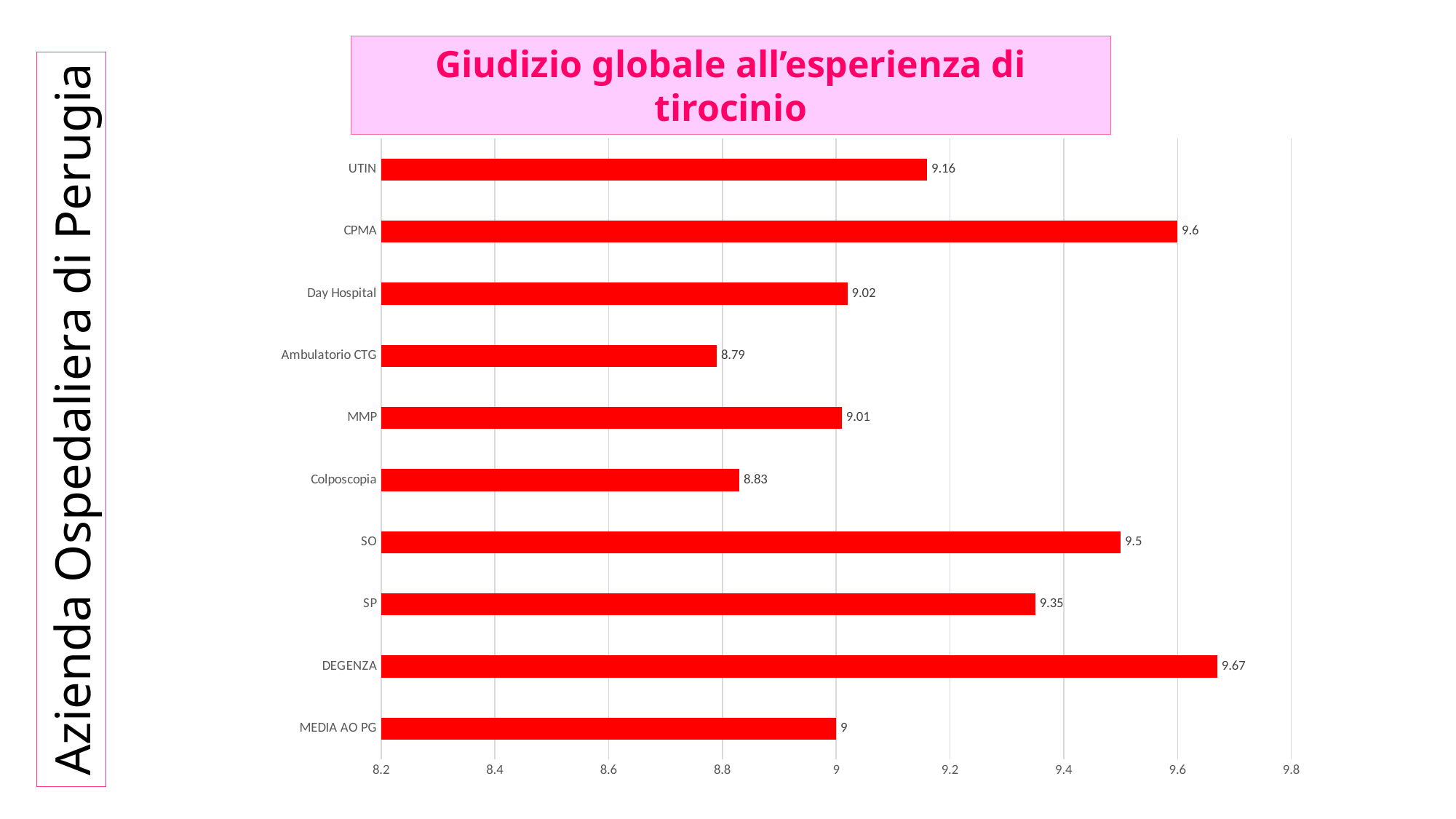
What is the title of the chart? Giudizio globale all'esperienza di tirocinio Which is larger, the value for SP or the value for UTIN? SP What is the value for Ambulatorio CTG? 8.79 What kind of chart is shown on the slide? bar chart Which category has the lowest value? Ambulatorio CTG What is the difference between the values for DEGENZA and SO? 0.17 What is the value for MEDIA AO PG? 9 How many categories are shown in the chart? 10 Is the value for Colposcopia greater or less than 9? less What is the value for CPMA? 9.6 What colour are the bars in the chart? red Which category has the highest value? DEGENZA